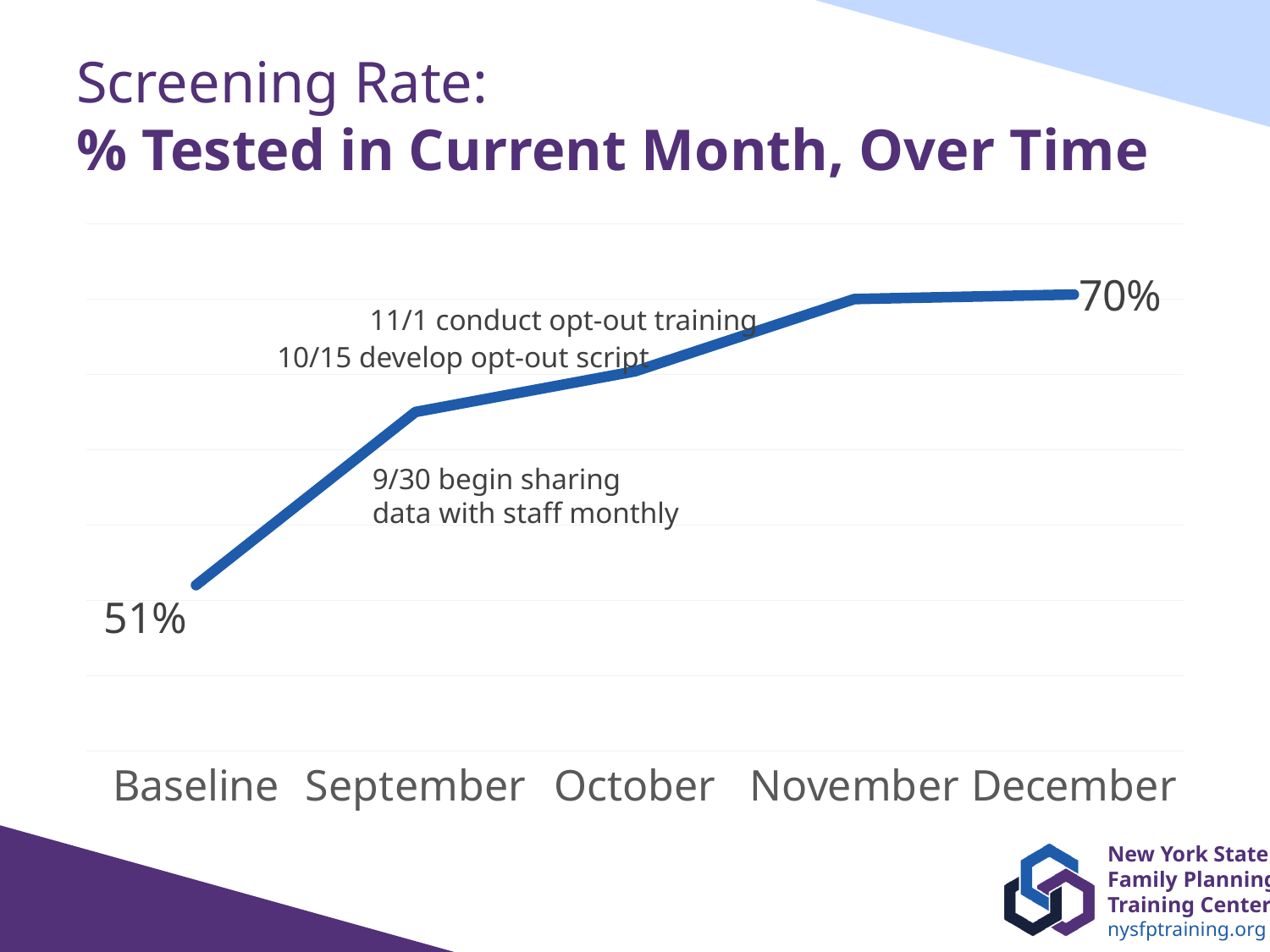
What kind of chart is this? Line chart Which category has the lowest value? Baseline How many categories are shown on the x axis? 5 Which is larger, the value for Baseline or the value for October? October Which category has the highest value? November and December (tied at 70%) What is the value for Baseline? 51% What is the difference between the December value and the Baseline value? 19 percentage points Do the values rise or fall from Baseline to December? Rise What is the title of the chart? Screening Rate: % Tested in Current Month, Over Time What event is annotated on the chart for 11/1? Conduct opt-out training What is the value for December? 70% Which is larger, the value for September or the value for November? November